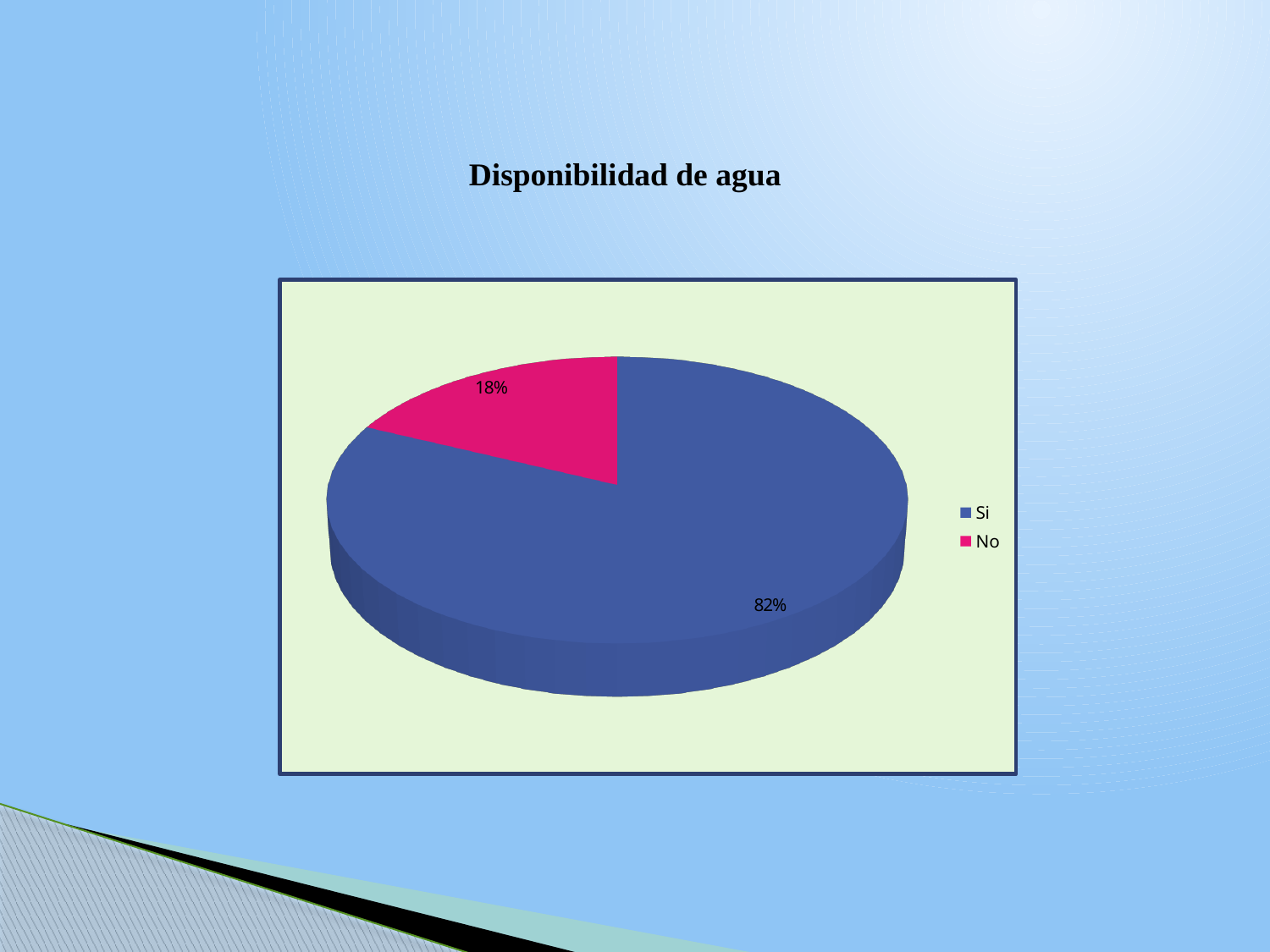
What percentage of the pie is labelled "No"? 18% What kind of chart is shown on the slide? pie chart How many entries does the legend list? 2 Which category has the smallest share of the pie? No Which slice is larger, "Si" or "No"? Si What is the title of the chart? Disponibilidad de agua Which category has the largest share of the pie? Si What percentage of the pie is labelled "Si"? 82% What share of the pie does the "Si" slice represent? 82% What is the difference in percentage points between the "Si" and "No" slices? 64 How many slices does the pie chart have? 2 What colour is the "No" slice? pink